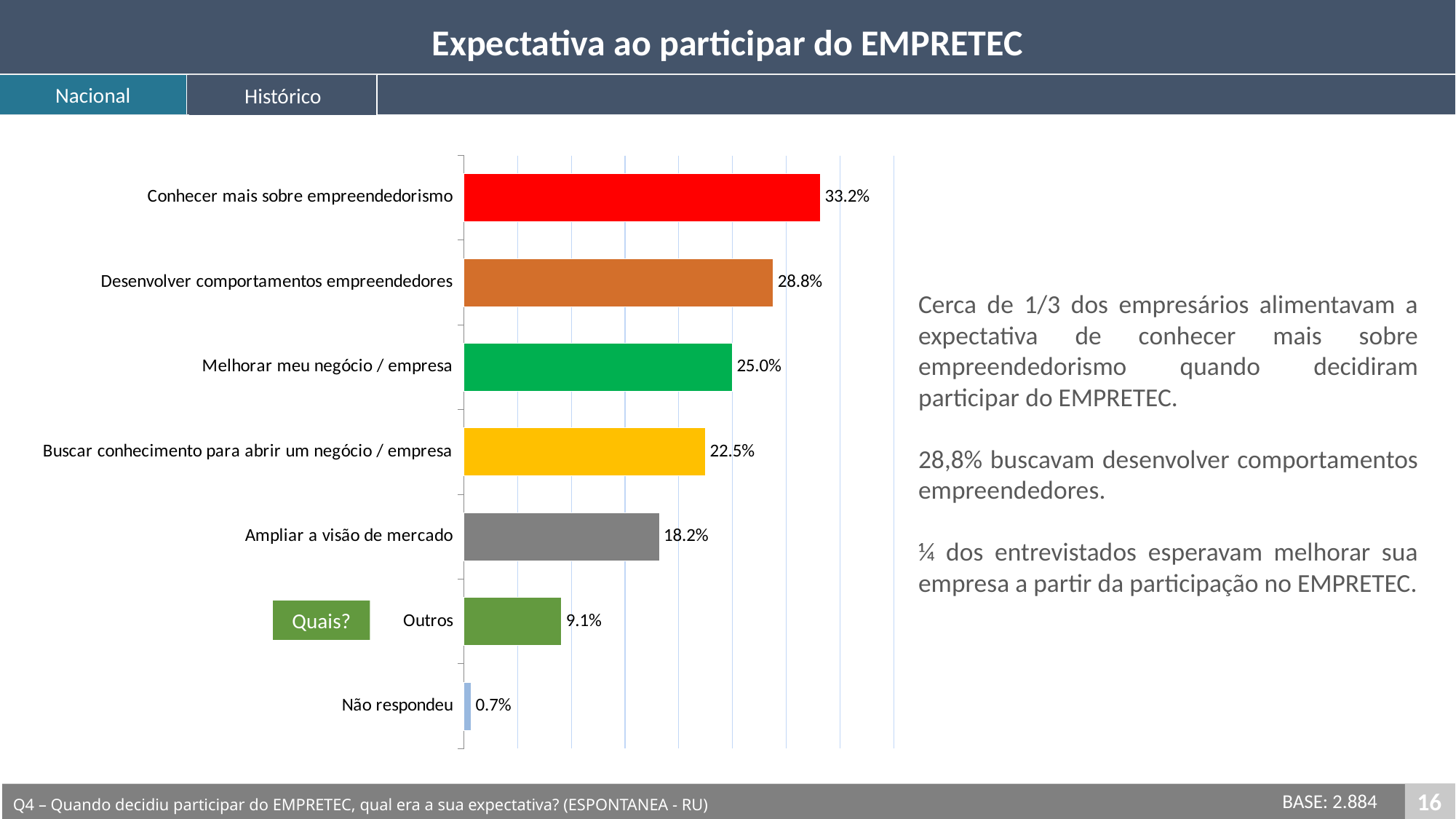
What is the title of the slide? Expectativa ao participar do EMPRETEC What is the value for "Ampliar a visão de mercado"? 18.2% What kind of chart is shown on the slide? Bar chart What is the difference between "Melhorar meu negócio / empresa" and "Buscar conhecimento para abrir um negócio / empresa"? 2.5% What is the value for "Conhecer mais sobre empreendedorismo"? 33.2% What is the difference between "Conhecer mais sobre empreendedorismo" and "Desenvolver comportamentos empreendedores"? 4.4% Which is larger: "Ampliar a visão de mercado" or "Outros"? Ampliar a visão de mercado Which category has the highest value? Conhecer mais sobre empreendedorismo What is the value for "Não respondeu"? 0.7% What colour is the bar for "Melhorar meu negócio / empresa"? Green Which category has the lowest value? Não respondeu How many categories does the chart show? 7